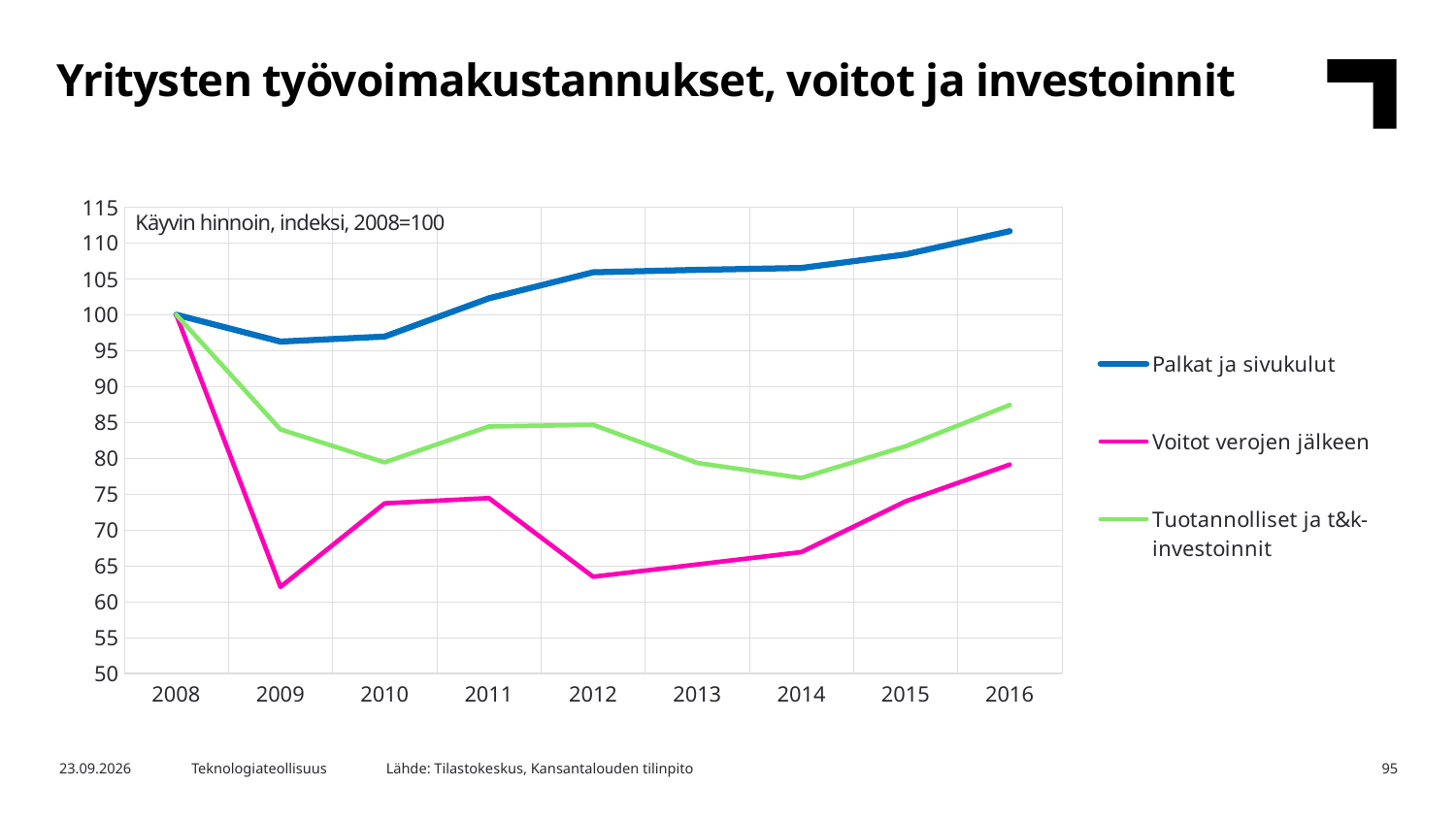
Is the value for Voitot verojen jälkeen in 2009 greater or less than 65? less In which year is Palkat ja sivukulut at its highest? 2016 Is the value for Tuotannolliset ja t&k-investoinnit in 2014 greater or less than 80? less How many series does the legend list? 3 Which series has the lowest value in 2009? Voitot verojen jälkeen How many years are shown on the x axis? 9 Does Palkat ja sivukulut rise or fall from 2010 to 2016? rise What type of chart is shown on the slide? line chart What is the value of Palkat ja sivukulut in 2008? 100 Is the value for Palkat ja sivukulut in 2009 greater or less than 100? less In 2016, which is larger: Palkat ja sivukulut or Voitot verojen jälkeen? Palkat ja sivukulut